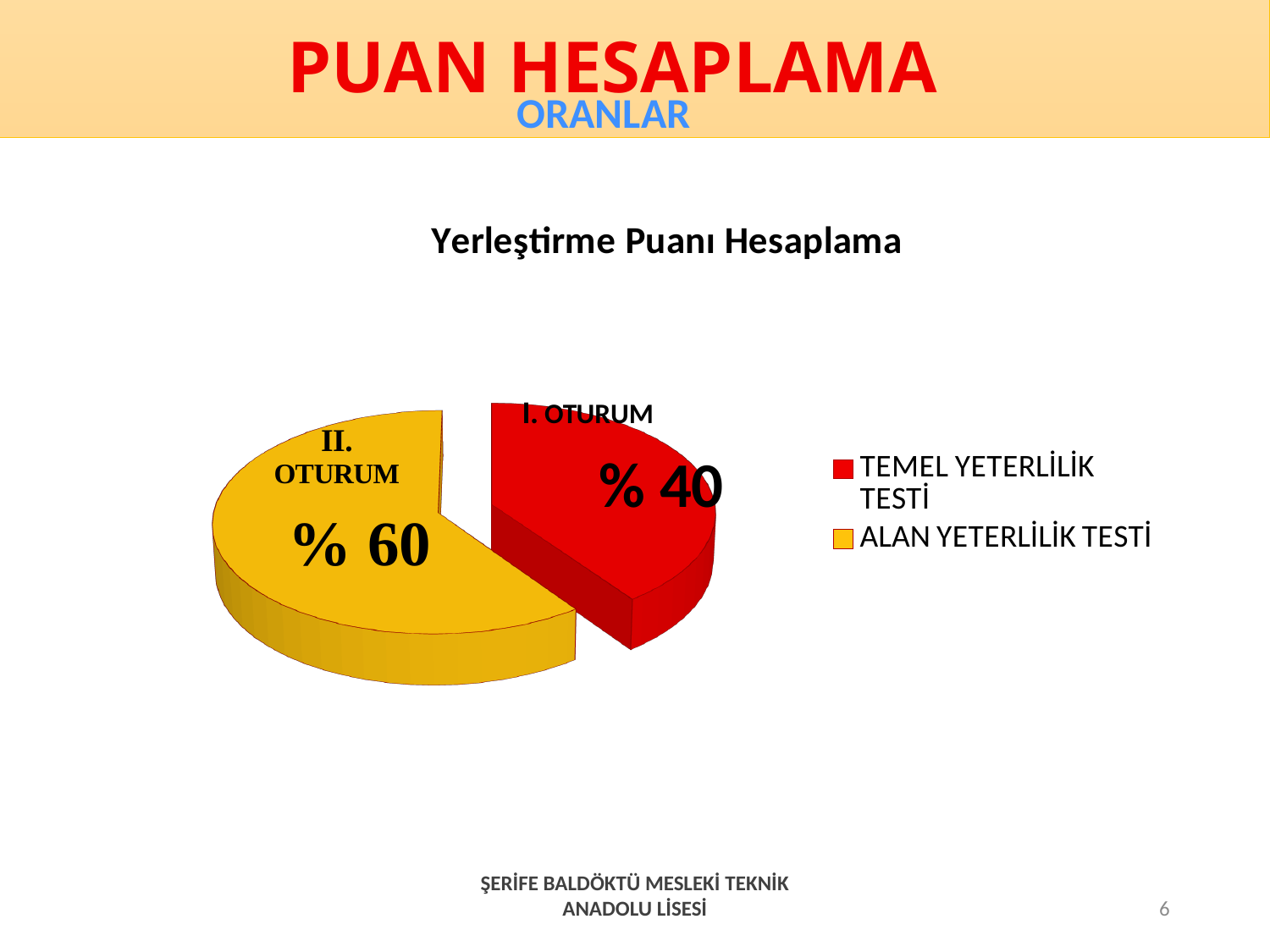
How many slices does the pie chart have? 2 What value is shown for TEMEL YETERLİLİK TESTİ (I. OTURUM)? % 40 Which slice is the largest in the pie chart? ALAN YETERLİLİK TESTİ What kind of chart is shown on the slide? pie chart What share of the pie does the II. OTURUM slice represent? % 60 What colour is the slice for TEMEL YETERLİLİK TESTİ? red Which slice is the smallest in the pie chart? TEMEL YETERLİLİK TESTİ How many entries does the legend list? 2 What is the title of the chart? Yerleştirme Puanı Hesaplama What value is shown for ALAN YETERLİLİK TESTİ (II. OTURUM)? % 60 Which is larger, the share for I. OTURUM or the share for II. OTURUM? II. OTURUM What is the difference between the II. OTURUM share and the I. OTURUM share? % 20